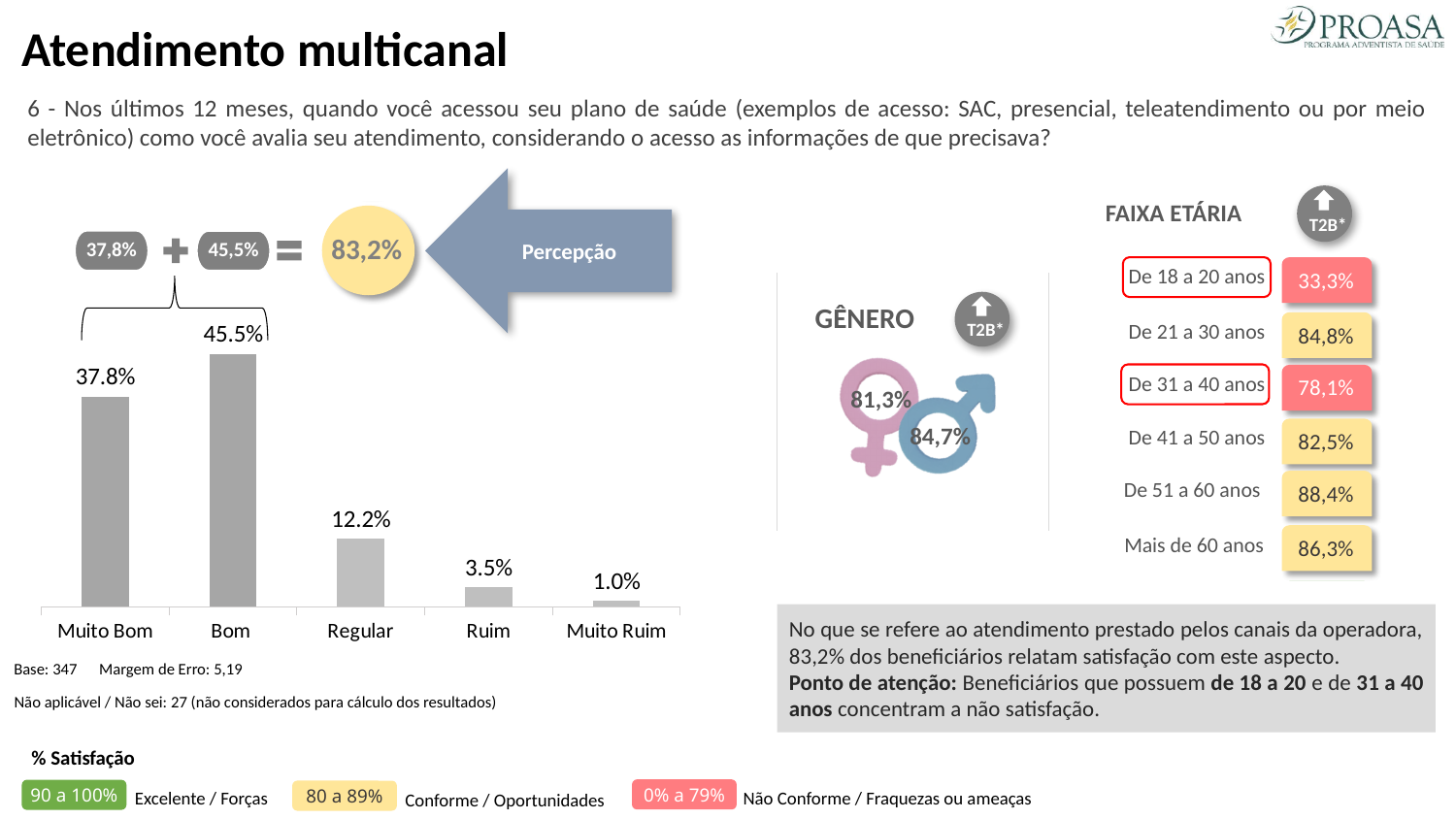
What is the value for Bom in the bar chart? 45.5% What is the value for Regular in the bar chart? 12.2% What is the difference between the values for Bom and Muito Bom in the bar chart? 7.7% What is the value for Muito Ruim in the bar chart? 1.0% What type of chart is used to show the ratings from Muito Bom to Muito Ruim? bar chart Which is larger in the bar chart, Regular or Ruim? Regular Do the values in the bar chart rise or fall from Bom to Muito Ruim? fall What is the combined value of Muito Bom and Bom shown in the circle above the bar chart? 83,2% How many categories are shown in the bar chart? 5 Which category has the lowest value in the bar chart? Muito Ruim Which category has the highest value in the bar chart? Bom What base (number of respondents) is stated below the bar chart? 347